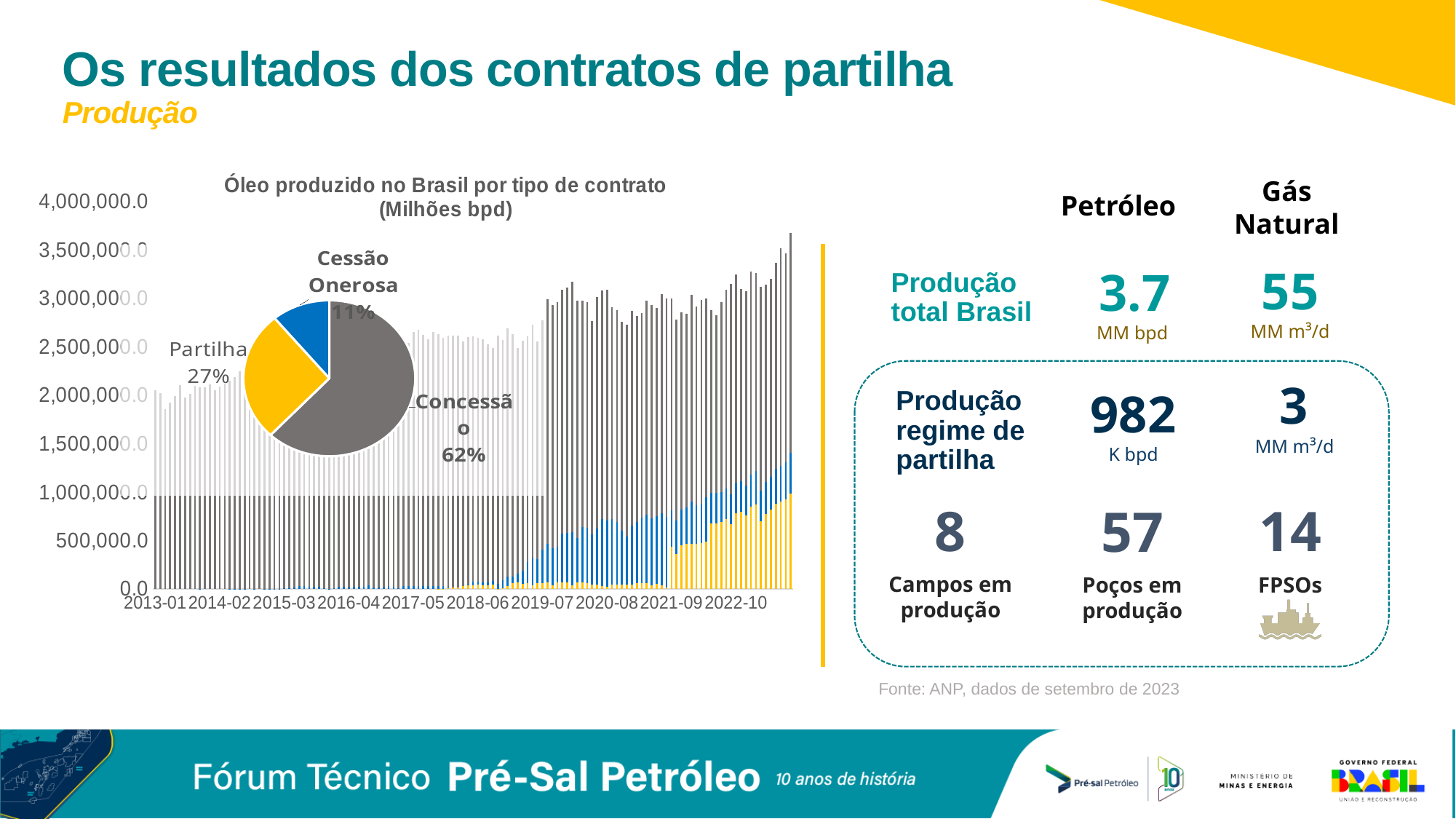
In the bar chart, do total production values generally rise or fall from 2013-01 to the end of the series? Rise In the pie chart, which contract type has the largest share? Concessão What is the title of the bar chart? Óleo produzido no Brasil por tipo de contrato (Milhões bpd) What kind of chart is the large chart showing monthly production from 2013-01 onward? Bar chart In the pie chart, which contract type has the smallest share? Cessão Onerosa In the pie chart, how many percentage points larger is the Concessão share than the Partilha share? 35 In the bar chart, is the total production value for 2013-01 greater or less than 2,500,000.0? less In the pie chart, which is larger: the Partilha share or the Cessão Onerosa share? Partilha In the pie chart, what share of oil production comes from Concessão contracts? 62% In the pie chart, what share of oil production comes from Partilha contracts? 27% In the pie chart, what share of oil production comes from Cessão Onerosa contracts? 11% How many slices does the pie chart have? 3